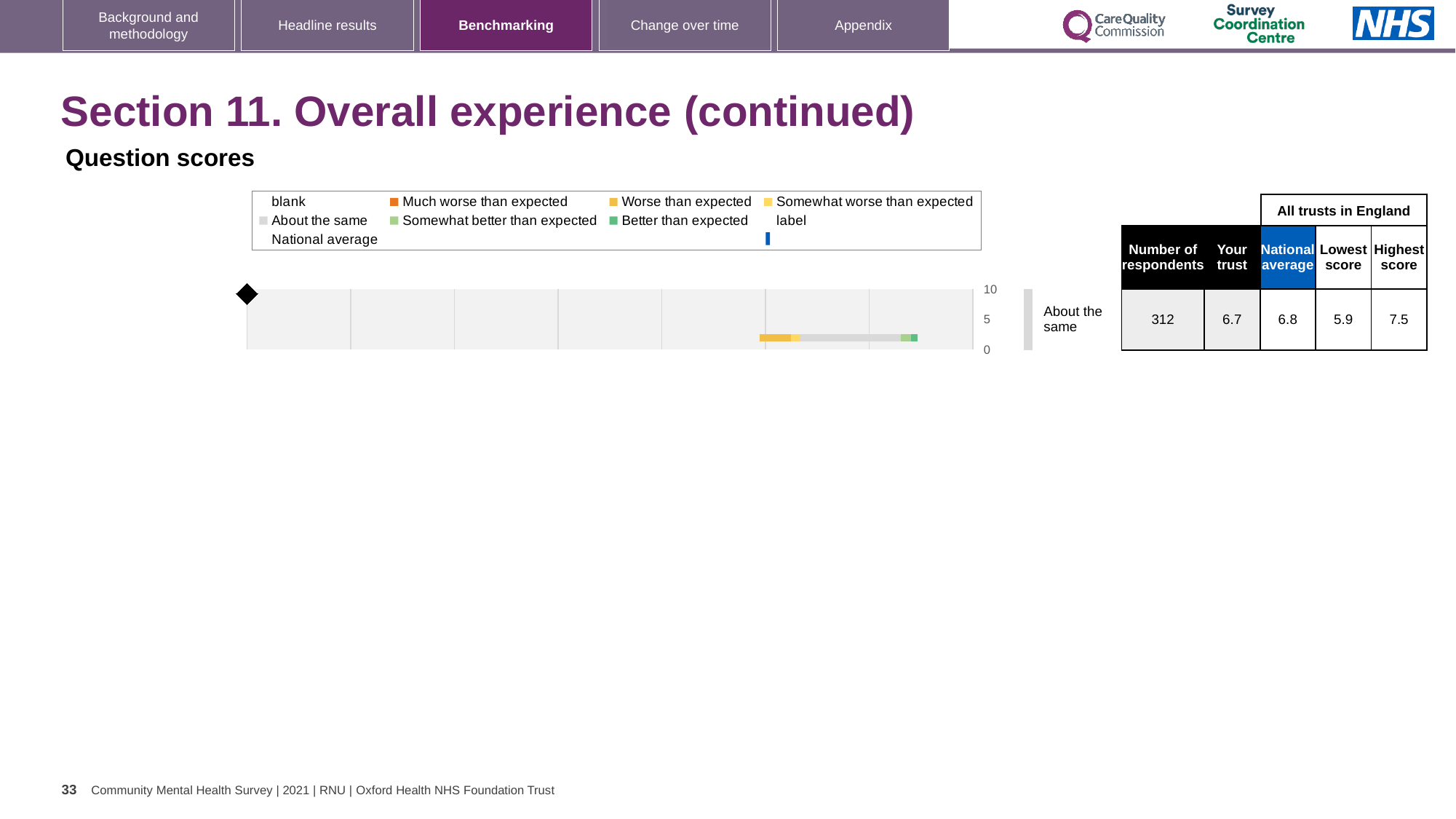
What is the highest score among all trusts in England for this question? 7.5 What is the difference between the highest score and the lowest score among all trusts in England? 1.6 What is the 'Your trust' score for the 'About the same' question? 6.7 What is the category label shown next to the bar in the chart? About the same How many categories (bars) does the chart show? 1 Is the 'Your trust' score greater or less than 5? greater What is the lowest score among all trusts in England for this question? 5.9 Which is larger, the 'Your trust' score or the national average? National average What kind of chart is shown on the slide? bar chart How many respondents answered this question? 312 What is the national average score for the 'About the same' question? 6.8 What is the highest value shown on the chart's axis? 10